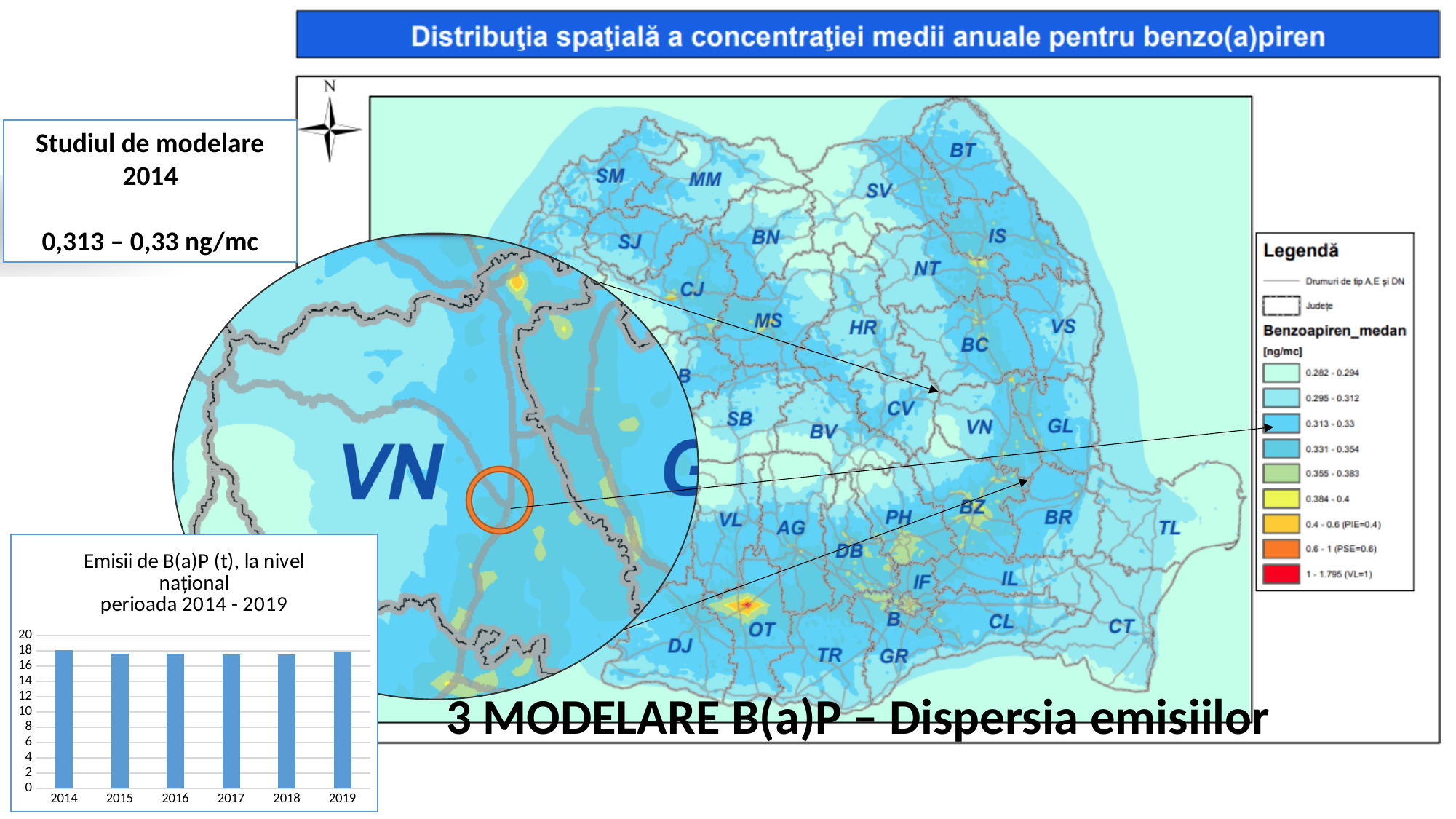
How many years are shown on the x axis of the bar chart? 6 In the bar chart, is the value for 2016 greater or less than 10? greater In the bar chart, is the value for 2014 greater or less than 16? greater What is the maximum value shown on the y axis of the bar chart? 20 In the bar chart, is the value for 2018 greater or less than 20? less What is the last year shown on the x axis of the bar chart? 2019 What kind of chart is shown at the bottom left of the slide? bar chart What is the first year shown on the x axis of the bar chart? 2014